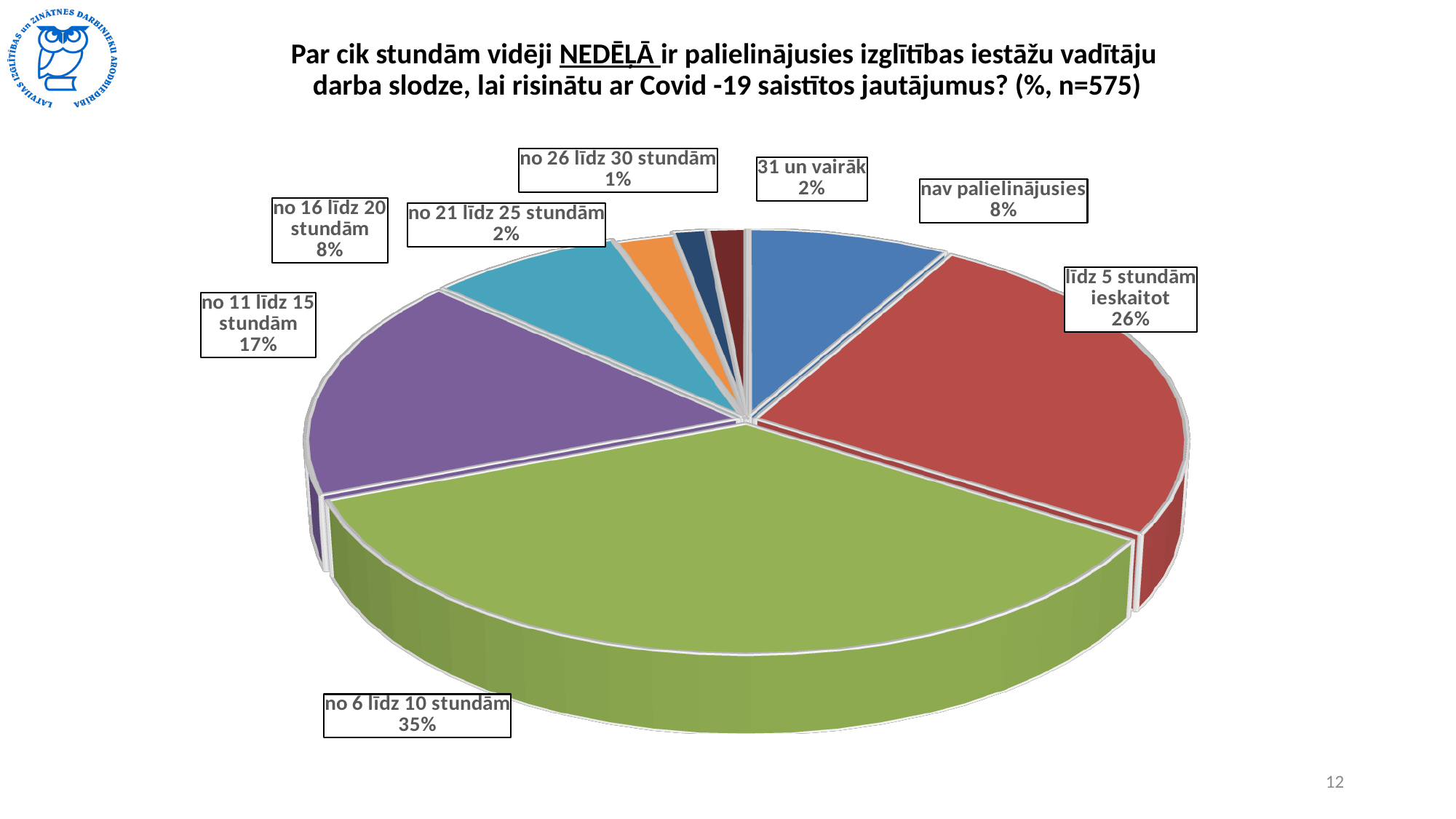
What share of respondents answered "no 11 līdz 15 stundām"? 17% What kind of chart is shown on the slide? pie chart Which category has the smallest share of the pie? no 26 līdz 30 stundām What sample size (n) is stated in the chart title? n=575 What share of respondents answered "no 6 līdz 10 stundām"? 35% What share of respondents answered "nav palielinājusies"? 8% What share of respondents answered "līdz 5 stundām ieskaitot"? 26% Which is larger: the share for "no 11 līdz 15 stundām" or for "no 16 līdz 20 stundām"? no 11 līdz 15 stundām What is the difference in percentage points between "no 6 līdz 10 stundām" and "līdz 5 stundām ieskaitot"? 9 How many categories (slices) does the pie chart have? 8 What share of respondents answered "31 un vairāk"? 2% Which category has the largest share of the pie? no 6 līdz 10 stundām